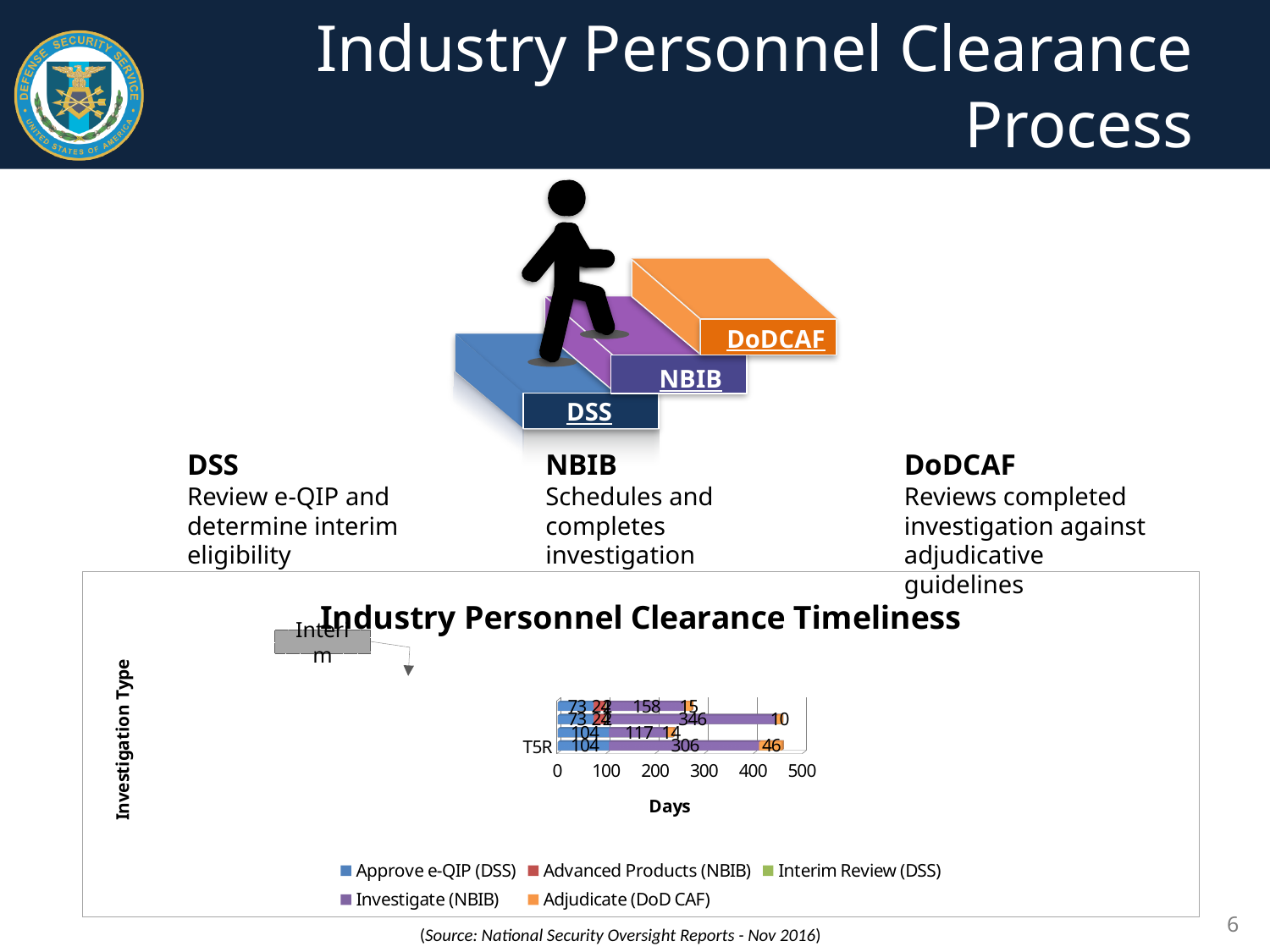
In the "Industry Personnel Clearance Timeliness" chart, which is larger for T5R: Investigate (NBIB) or Approve e-QIP (DSS)? Investigate (NBIB) In the "Industry Personnel Clearance Timeliness" chart, what is the Investigate (NBIB) value for T5R? 306 What is the x-axis title of the "Industry Personnel Clearance Timeliness" chart? Days In the "Industry Personnel Clearance Timeliness" chart, what is the difference between the Investigate (NBIB) and Approve e-QIP (DSS) values for T5R? 202 What type of chart is shown under the title "Industry Personnel Clearance Timeliness"? Stacked bar chart In the "Industry Personnel Clearance Timeliness" chart, what is the Adjudicate (DoD CAF) value for T5R? 46 What is the title of the chart at the bottom of the slide? Industry Personnel Clearance Timeliness In the "Industry Personnel Clearance Timeliness" chart, what is the Approve e-QIP (DSS) value for T5R? 104 In the "Industry Personnel Clearance Timeliness" chart, is the total length of the T5R bar greater or less than 400 days? greater How many series does the legend of the "Industry Personnel Clearance Timeliness" chart list? 5 In the "Industry Personnel Clearance Timeliness" chart, what is the total of the T5R bar (104 + 306 + 46)? 456